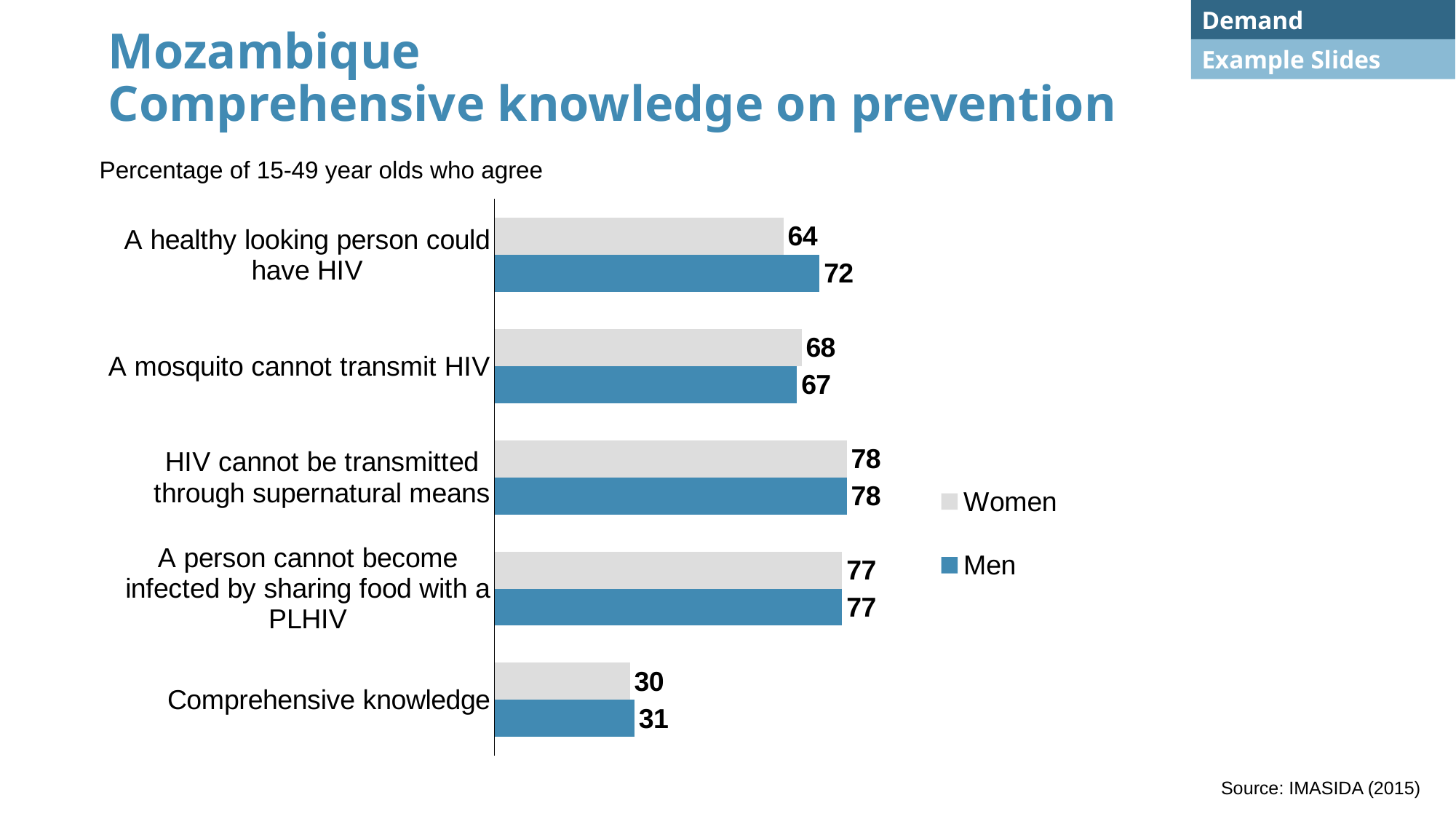
What percentage of women agree that a healthy looking person could have HIV? 64 What is the value for men for 'Comprehensive knowledge'? 31 What type of chart is shown on the slide? Bar chart Which category has the lowest value for women? Comprehensive knowledge How many categories are shown on the chart? 5 Which category has the highest value for men? HIV cannot be transmitted through supernatural means How many series does the legend list? 2 Which series is shown in blue in the legend? Men For 'A healthy looking person could have HIV', is the value higher for women or men? Men What is the difference between men and women for 'A healthy looking person could have HIV'? 8 What percentage of men agree that a mosquito cannot transmit HIV? 67 What is the value for women for 'A person cannot become infected by sharing food with a PLHIV'? 77